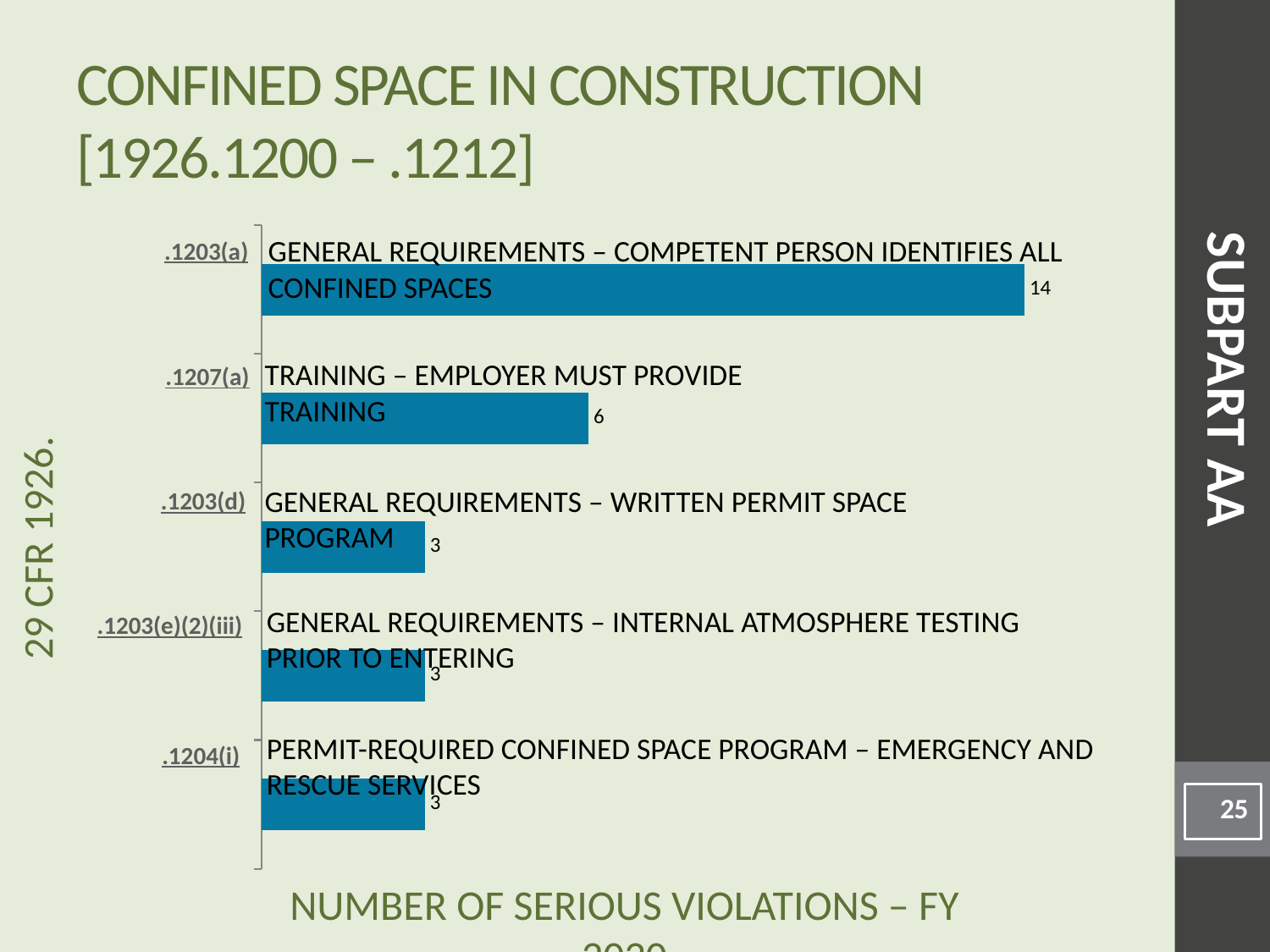
How many standards (categories) are shown in the chart? 5 Which standard has the highest number of serious violations? .1203(a) What is the number of serious violations for .1207(a)? 6 What is the number of serious violations for .1203(a)? 14 What is the difference between the number of serious violations for .1203(a) and .1207(a)? 8 How many categories share the lowest value of 3 serious violations? 3 What is the number of serious violations for .1204(i)? 3 What is the total number of serious violations across all five standards shown? 29 What kind of chart is shown on the slide? Bar chart Which has more serious violations, .1207(a) or .1203(e)(2)(iii)? .1207(a) What is the difference between the number of serious violations for .1207(a) and .1203(d)? 3 What is the number of serious violations for .1203(d)? 3